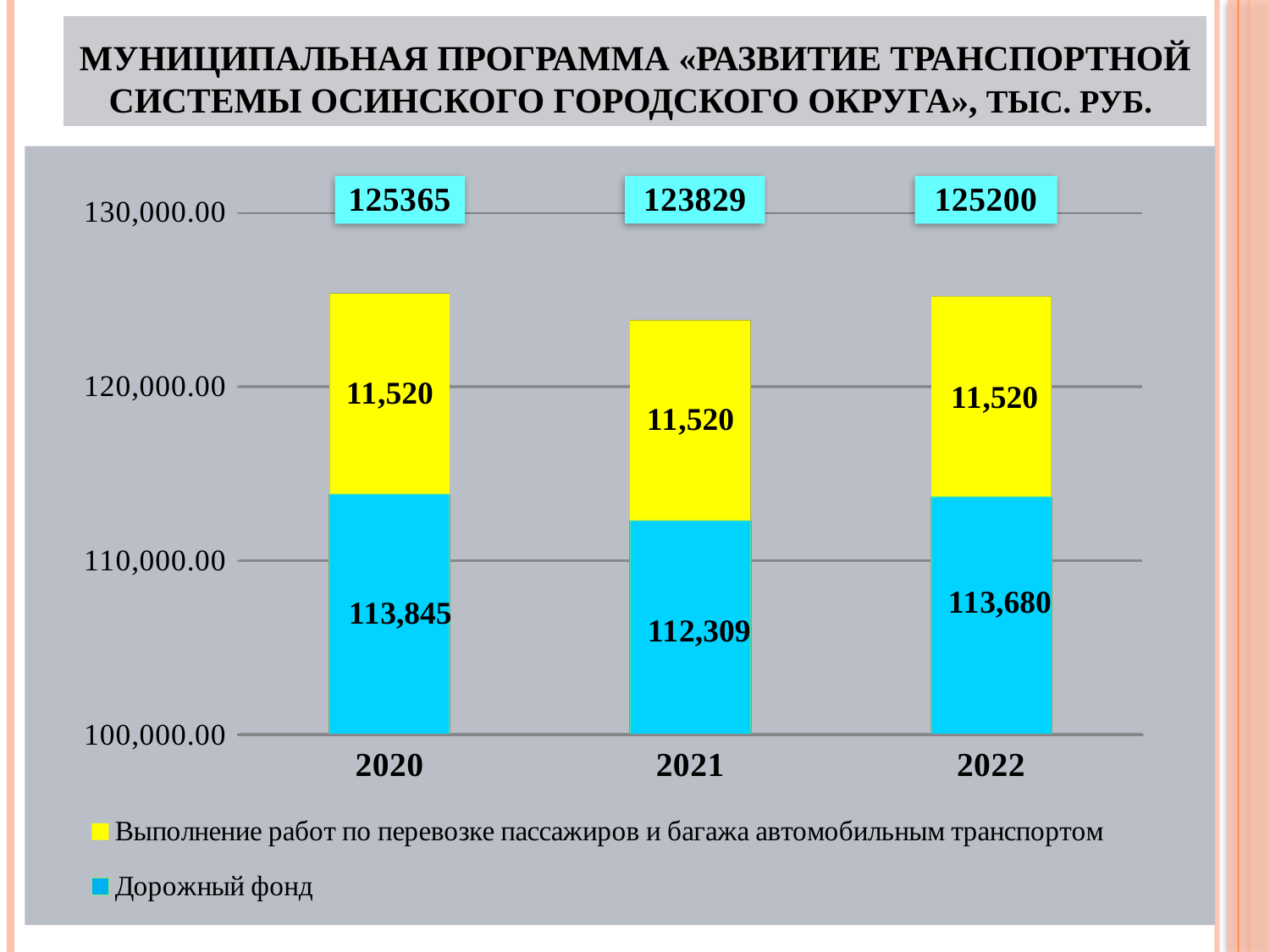
What is the value of Дорожный фонд for 2020? 113,845 What is the total of the stacked bar for 2021? 123829 What is the value of Дорожный фонд for 2022? 113,680 How many years are shown on the x axis? 3 How many series does the legend list? 2 What kind of chart is shown on the slide? Stacked bar chart What is the value of Дорожный фонд for 2021? 112,309 Is the Дорожный фонд value for 2022 larger than the value for 2021? Yes What is the value of Выполнение работ по перевозке пассажиров и багажа автомобильным транспортом for 2021? 11,520 Which year has the highest value for Дорожный фонд? 2020 What is the difference between the Дорожный фонд values for 2020 and 2021? 1,536 Which year has the lowest value for Дорожный фонд? 2021